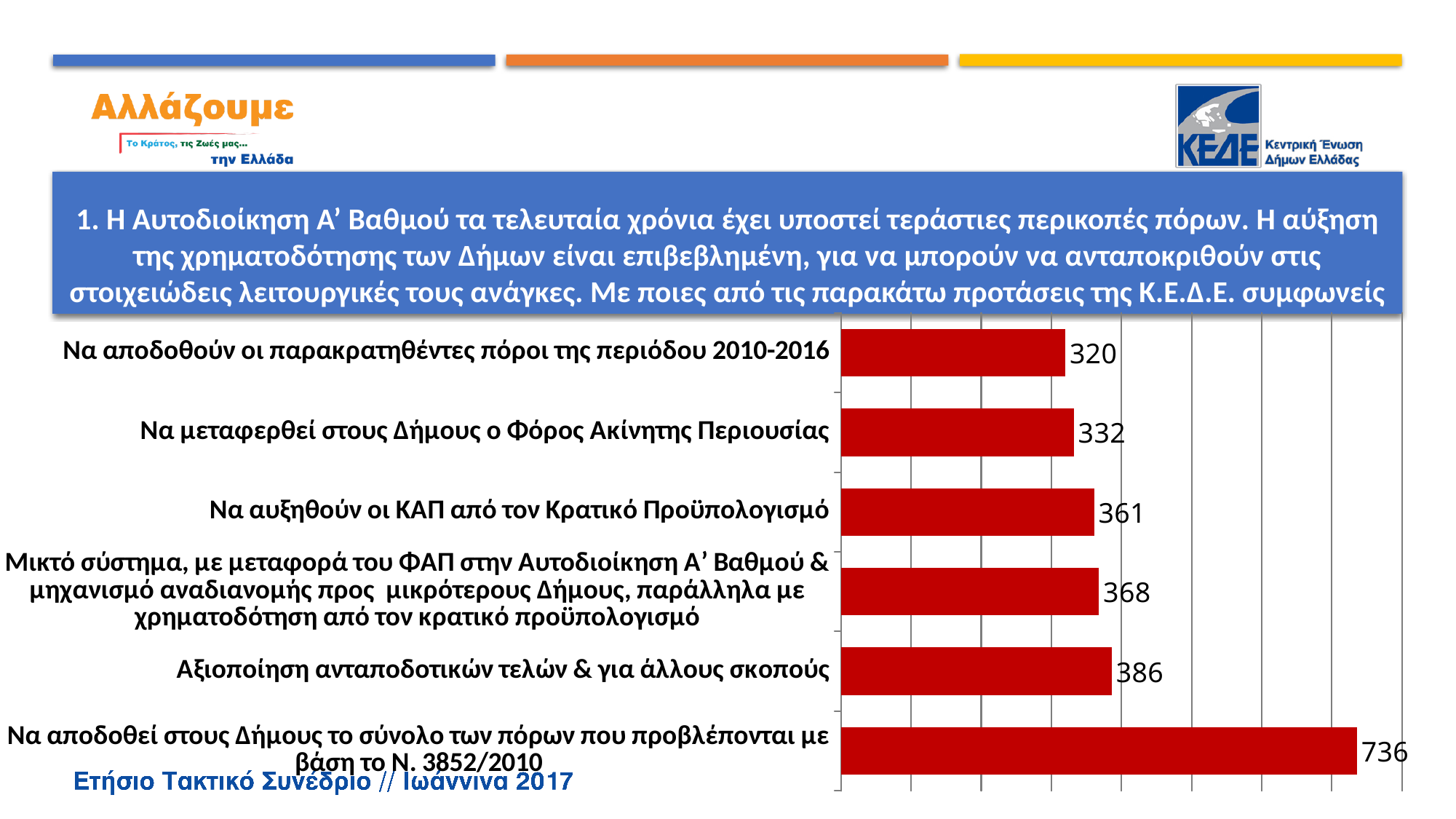
What is the value for "Να αυξηθούν οι ΚΑΠ από τον Κρατικό Προϋπολογισμό"? 361 What colour are the bars in the chart? Red What kind of chart is shown on the slide? Bar chart What is the difference between the value for "Να αυξηθούν οι ΚΑΠ από τον Κρατικό Προϋπολογισμό" and the value for "Να αποδοθούν οι παρακρατηθέντες πόροι της περιόδου 2010-2016"? 41 What is the value for "Αξιοποίηση ανταποδοτικών τελών & για άλλους σκοπούς"? 386 Which category has the highest value? Να αποδοθεί στους Δήμους το σύνολο των πόρων που προβλέπονται με βάση το Ν. 3852/2010 How many categories are shown in the chart? 6 Which category has the lowest value? Να αποδοθούν οι παρακρατηθέντες πόροι της περιόδου 2010-2016 What is the value for "Να αποδοθούν οι παρακρατηθέντες πόροι της περιόδου 2010-2016"? 320 Which is larger: the value for "Να μεταφερθεί στους Δήμους ο Φόρος Ακίνητης Περιουσίας" or the value for "Να αυξηθούν οι ΚΑΠ από τον Κρατικό Προϋπολογισμό"? Να αυξηθούν οι ΚΑΠ από τον Κρατικό Προϋπολογισμό What is the value for "Να μεταφερθεί στους Δήμους ο Φόρος Ακίνητης Περιουσίας"? 332 What is the difference between the value for "Να αποδοθεί στους Δήμους το σύνολο των πόρων που προβλέπονται με βάση το Ν. 3852/2010" and the value for "Αξιοποίηση ανταποδοτικών τελών & για άλλους σκοπούς"? 350